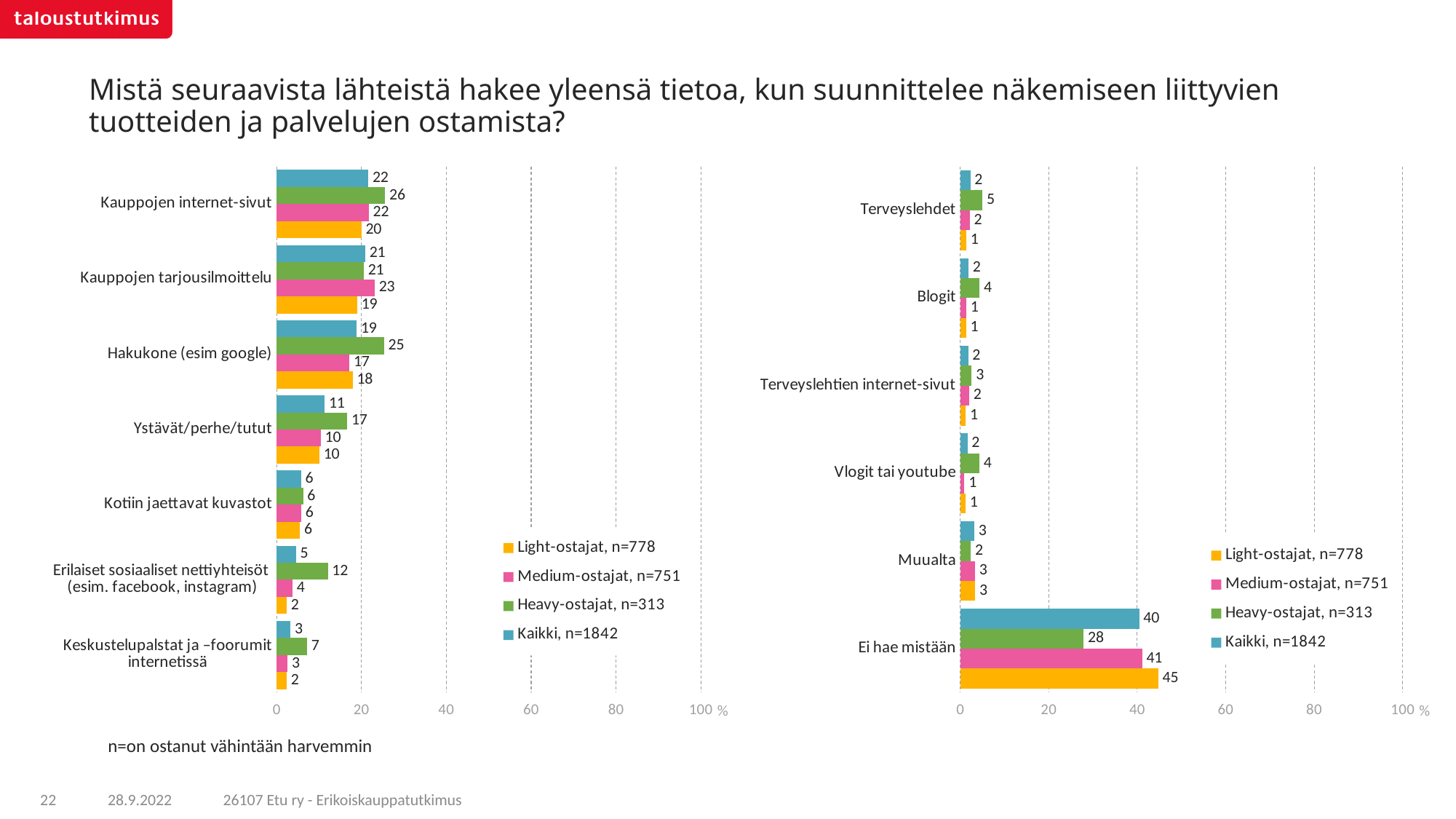
How many series does the legend of the right chart list? 4 In the left chart, what is the difference between Heavy-ostajat and Medium-ostajat for Hakukone (esim google)? 8 How many categories are shown in the left chart? 7 What type of chart is the left chart? bar chart In the left chart, which category has the lowest value for Heavy-ostajat? Kotiin jaettavat kuvastot In the right chart, which is larger for Ei hae mistään: Medium-ostajat or Heavy-ostajat? Medium-ostajat In the left chart, what is the difference between Heavy-ostajat and Light-ostajat for Erilaiset sosiaaliset nettiyhteisöt? 10 In the left chart, what is the value for Kaikki for Ystävät/perhe/tutut? 11 In the right chart, is the value for Kaikki for Ei hae mistään greater or less than 20? greater In the right chart, which category has the highest value for Kaikki? Ei hae mistään In the left chart, what is the value for Heavy-ostajat for Kauppojen internet-sivut? 26 In the right chart, what is the value for Light-ostajat for Ei hae mistään? 45